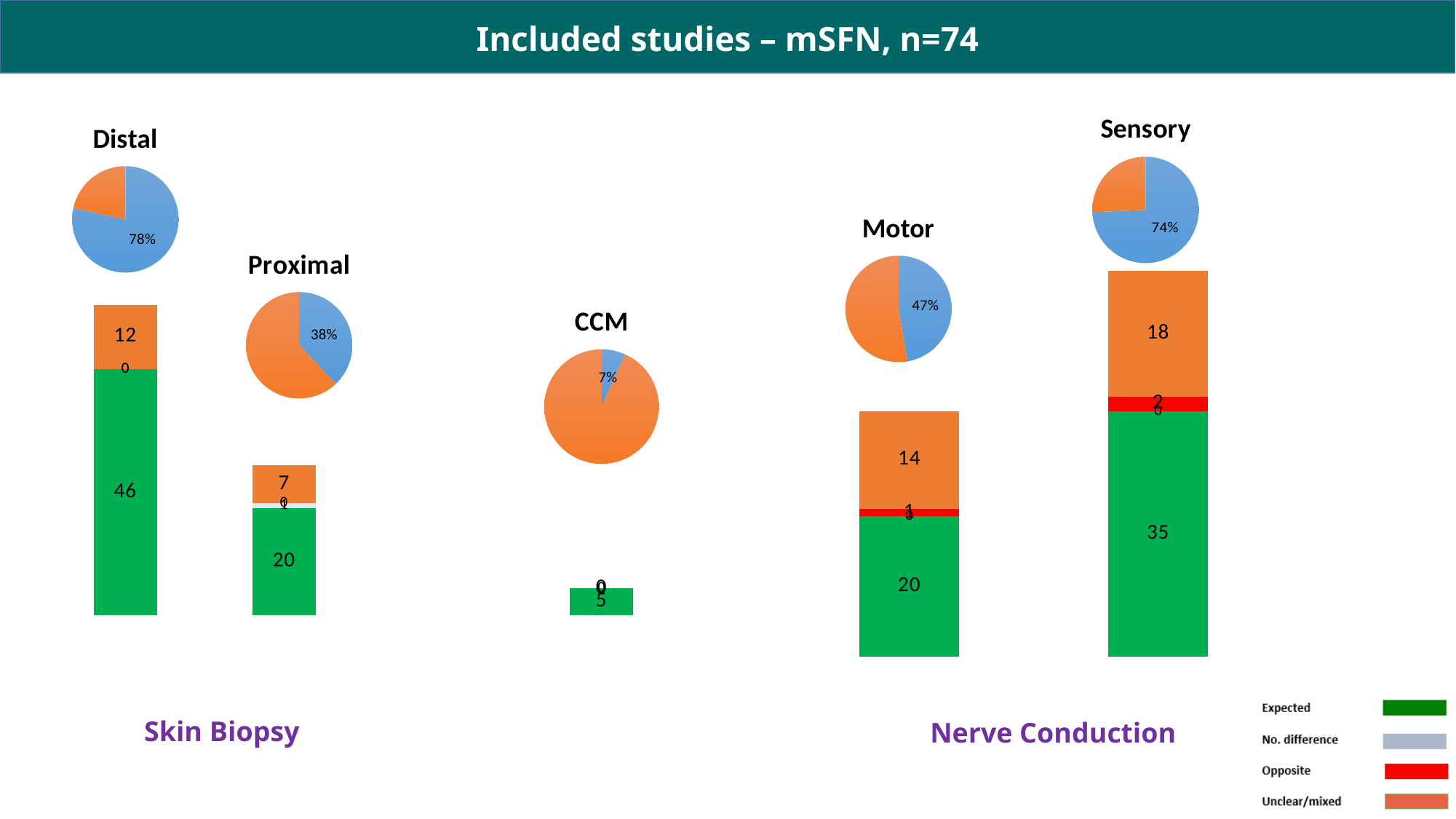
In the Proximal bar chart, what is the value of the Expected (green) segment? 20 Is the Unclear/mixed value larger in the Sensory bar chart or the Motor bar chart? Sensory In the Distal bar chart, what is the value of the Unclear/mixed (orange) segment? 12 What percentage is shown on the CCM pie chart? 7% In the Sensory bar chart, what is the value of the Unclear/mixed (orange) segment? 18 Which pie chart shows the lowest percentage? CCM In the Distal bar chart, what is the value of the Expected (green) segment? 46 What is the difference between the Expected values in the Distal and Sensory bar charts? 11 In the Motor bar chart, what is the value of the Unclear/mixed (orange) segment? 14 What percentage is shown on the Distal pie chart? 78% Which bar chart has the largest Expected (green) segment? Distal How many categories does the legend list? 4